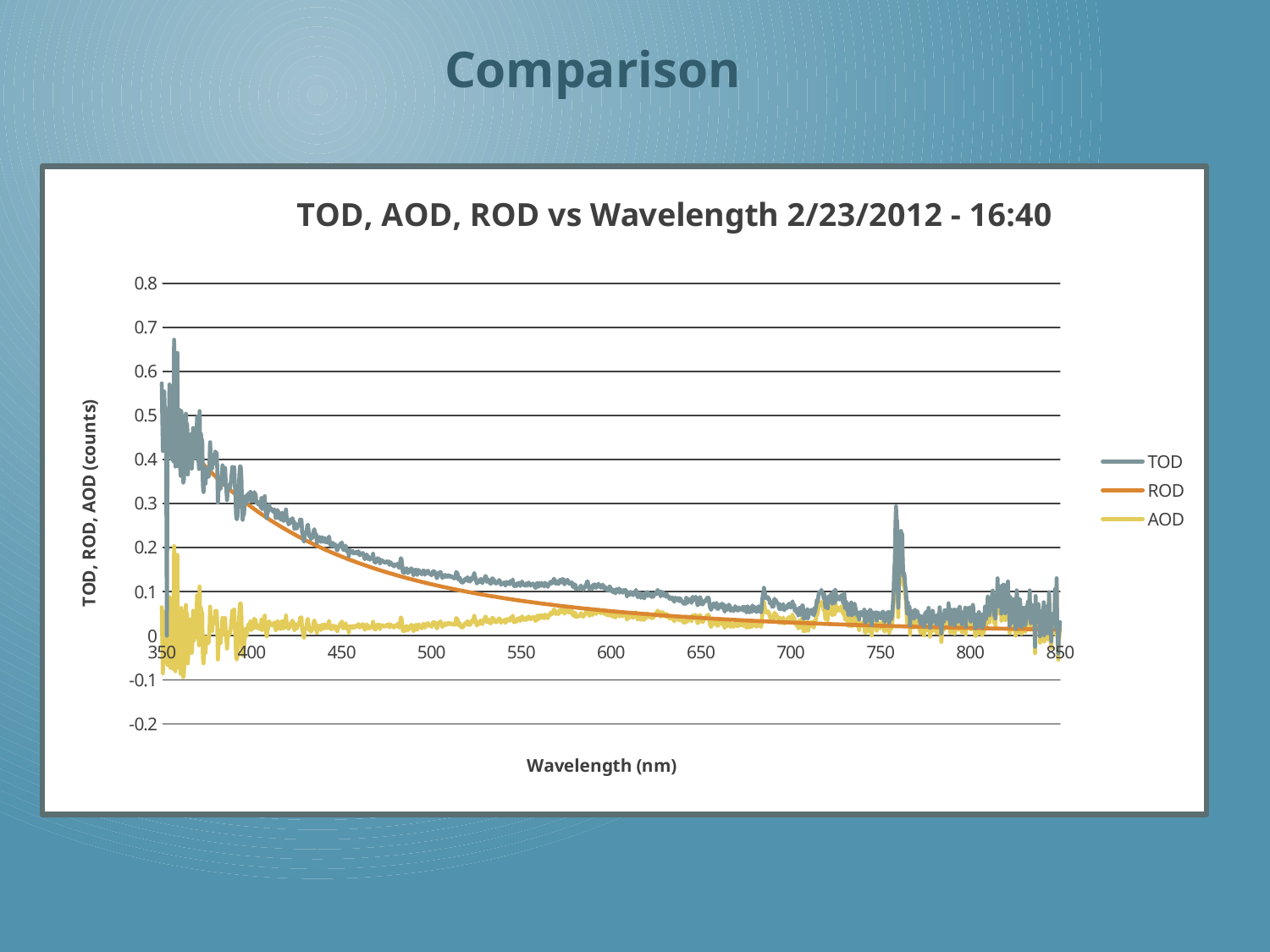
What kind of chart is shown on the slide? line chart At 700 nm, which series has the larger value, TOD or ROD? TOD Is the TOD value at 800 nm greater or less than 0.2? less Is the ROD value at 400 nm greater or less than 0.2? greater Is the TOD value at 400 nm greater or less than 0.2? greater What is the title of the chart? TOD, AOD, ROD vs Wavelength 2/23/2012 - 16:40 Does the TOD series generally rise or fall as wavelength increases from 350 nm to 850 nm? fall What are the three series named in the legend? TOD, ROD, AOD At 500 nm, which series has the larger value, TOD or AOD? TOD Does the ROD series rise or fall as wavelength increases along the x axis? fall How many series does the legend list? 3